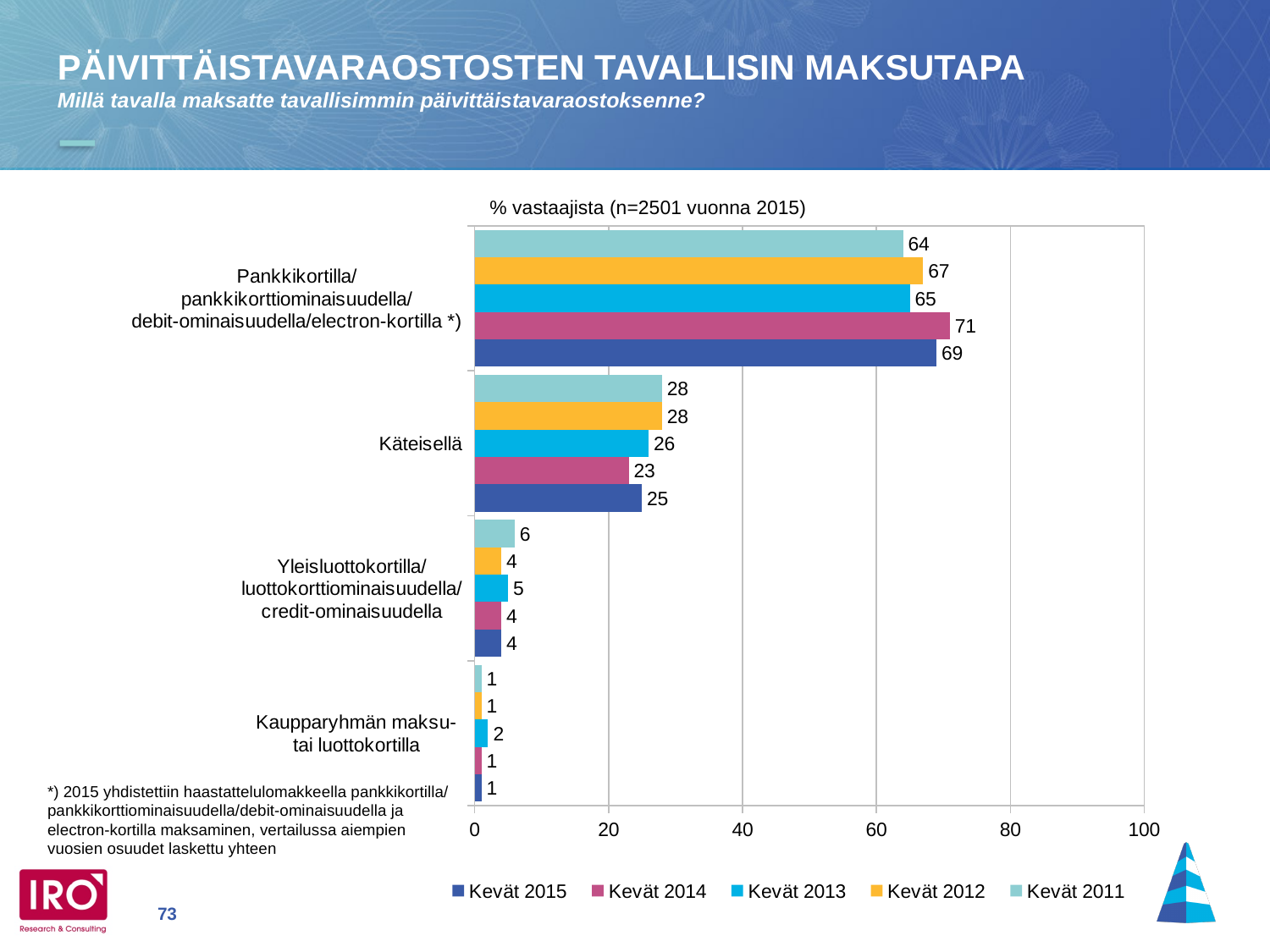
What is the difference between the Kevät 2014 and Kevät 2011 values in the Pankkikortilla category? 7 Which year has the highest value in the Pankkikortilla category? Kevät 2014 Which legend entry is shown in dark blue? Kevät 2015 What is the value for Kevät 2011 in the Yleisluottokortilla category? 6 How many payment-method categories are shown on the chart? 4 What is the value for Kevät 2013 in the Kaupparyhmän maksu- tai luottokortilla category? 2 What is the value for Kevät 2015 in the Pankkikortilla category? 69 What kind of chart is shown on the slide? bar chart How many series does the legend list? 5 What is the value for Kevät 2014 in the Käteisellä category? 23 Which year has the lowest value in the Käteisellä category? Kevät 2014 In the Käteisellä category, which is larger: the Kevät 2012 value or the Kevät 2015 value? Kevät 2012